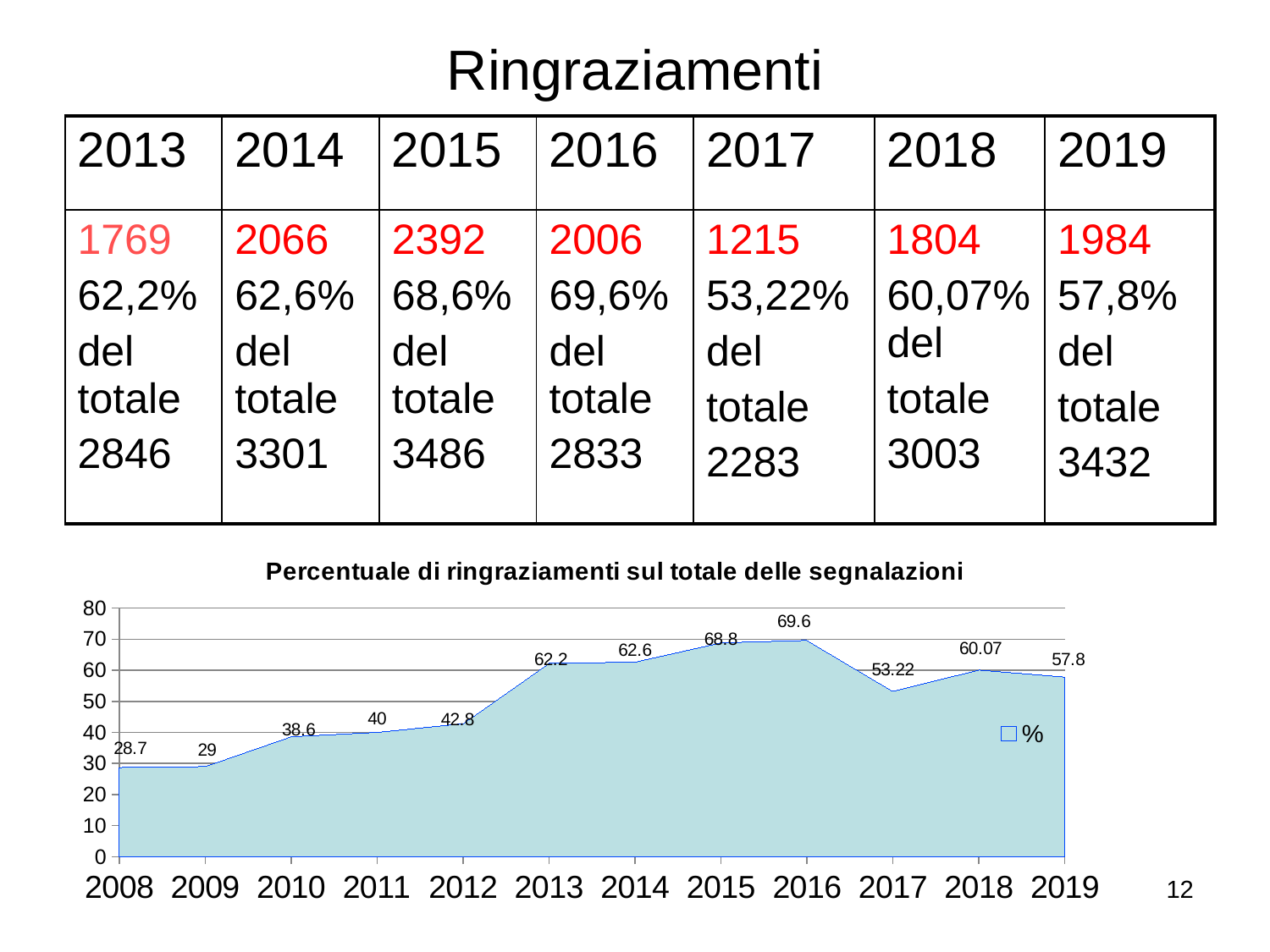
What is the value for 2008 in the chart? 28.7 Which is larger, the value for 2018 or the value for 2019? 2018 How many years are plotted on the x axis of the chart? 12 What kind of chart is shown on the slide? area chart What is the title of the chart? Percentuale di ringraziamenti sul totale delle segnalazioni What is the value for 2017 in the chart? 53.22 Which year has the lowest value in the chart? 2008 What is the difference between the values for 2016 and 2017? 16.38 How many series does the chart legend list? 1 What is the value for 2016 in the chart? 69.6 Is the value for 2013 greater or less than 50? greater Which year has the highest value in the chart? 2016